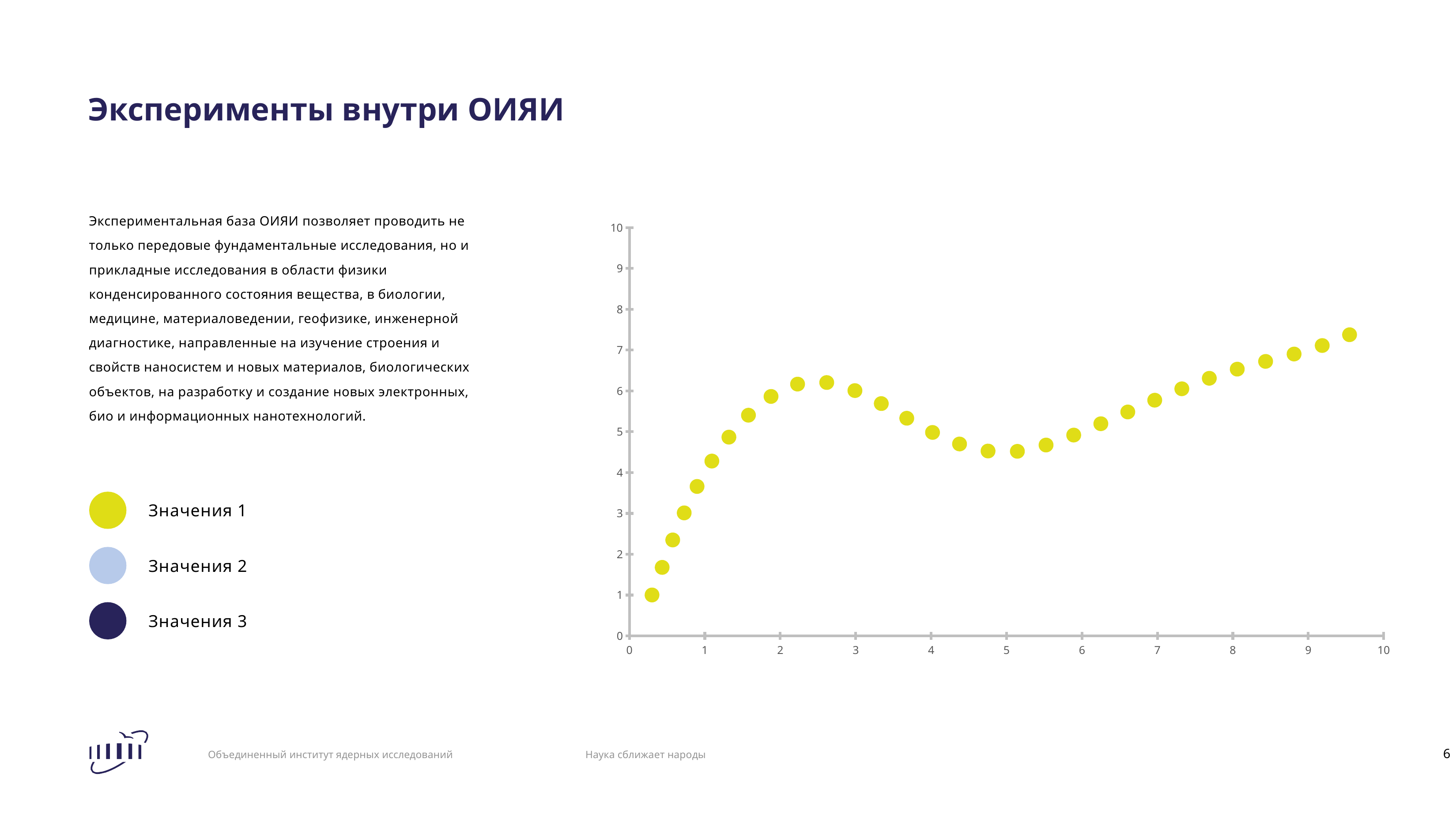
What colour are the plotted data points? yellow Is the value of the point plotted near x = 5 greater or less than 5? less Do the plotted values rise or fall between x = 3 and x = 5? fall What kind of chart is shown on the slide? scatter chart Is the value of the rightmost plotted point (near x = 9.5) greater or less than 7? greater Is the value of the point plotted near x = 2.6 greater or less than 5? greater Do the plotted values rise or fall between x = 6 and x = 9.5? rise How many series does the legend list? 3 How many data points are plotted on the chart? 30 Which plotted point has the lower value: the one near x = 1 or the one near x = 9? the one near x = 1 Which plotted point has the highest value: the one near x = 2.6 or the one near x = 9.5? the one near x = 9.5